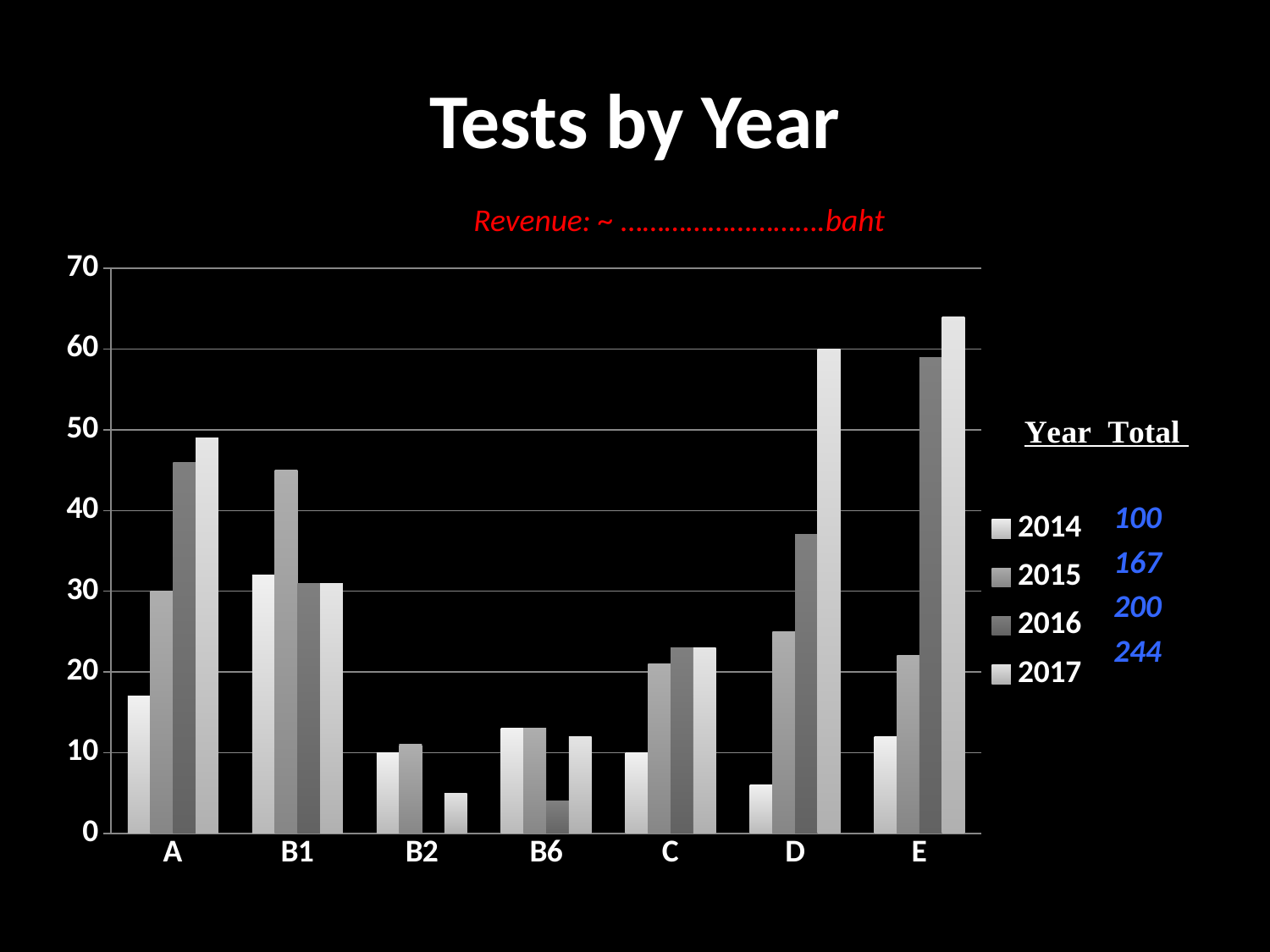
Which category has the highest 2014 bar? B1 For category A, which is larger: the 2016 value or the 2014 value? 2016 What is the title of the chart? Tests by Year What is the Year Total shown for 2014? 100 What is the Year Total shown for 2017? 244 How many series does the legend list? 4 Is the value for E in 2017 greater or less than 60? greater How many categories are shown on the x axis? 7 Which category has the lowest 2017 bar? B2 What kind of chart is shown on the slide? bar chart Which category has the highest 2017 bar? E Is the value for B2 in 2017 greater or less than 10? less